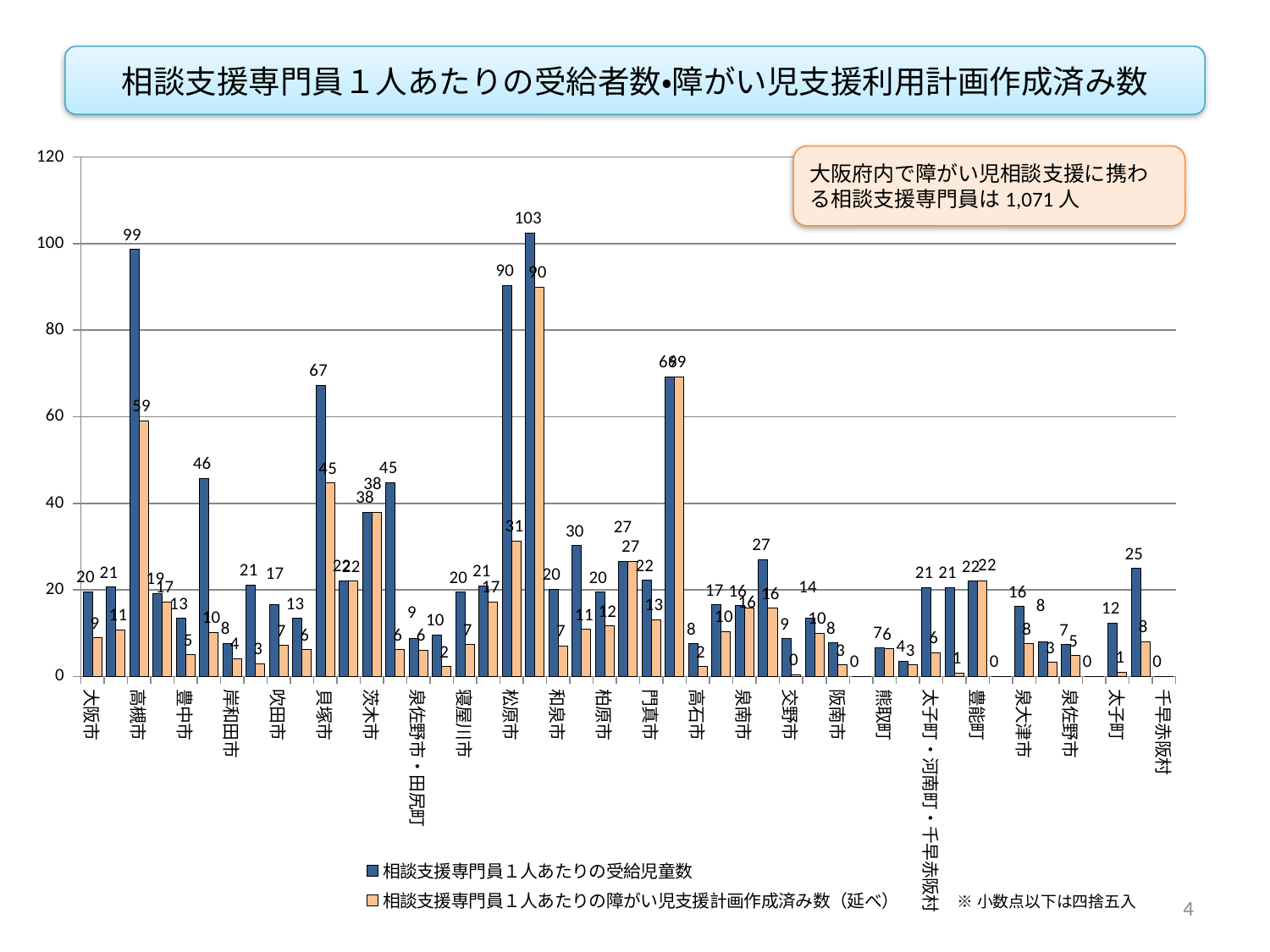
What is the difference between the two series values for 大阪市? 11 What is the value of 相談支援専門員１人あたりの受給児童数 for 大阪市? 20 What is the highest value among the orange bars (相談支援専門員１人あたりの障がい児支援計画作成済み数（延べ）)? 90 What kind of chart is shown on the slide? bar chart How many series does the legend list? 2 What is the value of 相談支援専門員１人あたりの障がい児支援計画作成済み数（延べ） for 大阪市? 9 What is the title of the chart on the slide? 相談支援専門員１人あたりの受給者数•障がい児支援利用計画作成済み数 Is the value of 相談支援専門員１人あたりの受給児童数 for 高槻市 greater or less than 80? greater According to the text box on the slide, how many 相談支援専門員 in 大阪府 are involved in 障がい児相談支援? 1,071 人 What is the highest value shown by any bar in the chart? 103 What is the value of 相談支援専門員１人あたりの受給児童数 for 高槻市? 99 For 高槻市, which series has the larger value: 相談支援専門員１人あたりの受給児童数 or 相談支援専門員１人あたりの障がい児支援計画作成済み数（延べ）? 相談支援専門員１人あたりの受給児童数